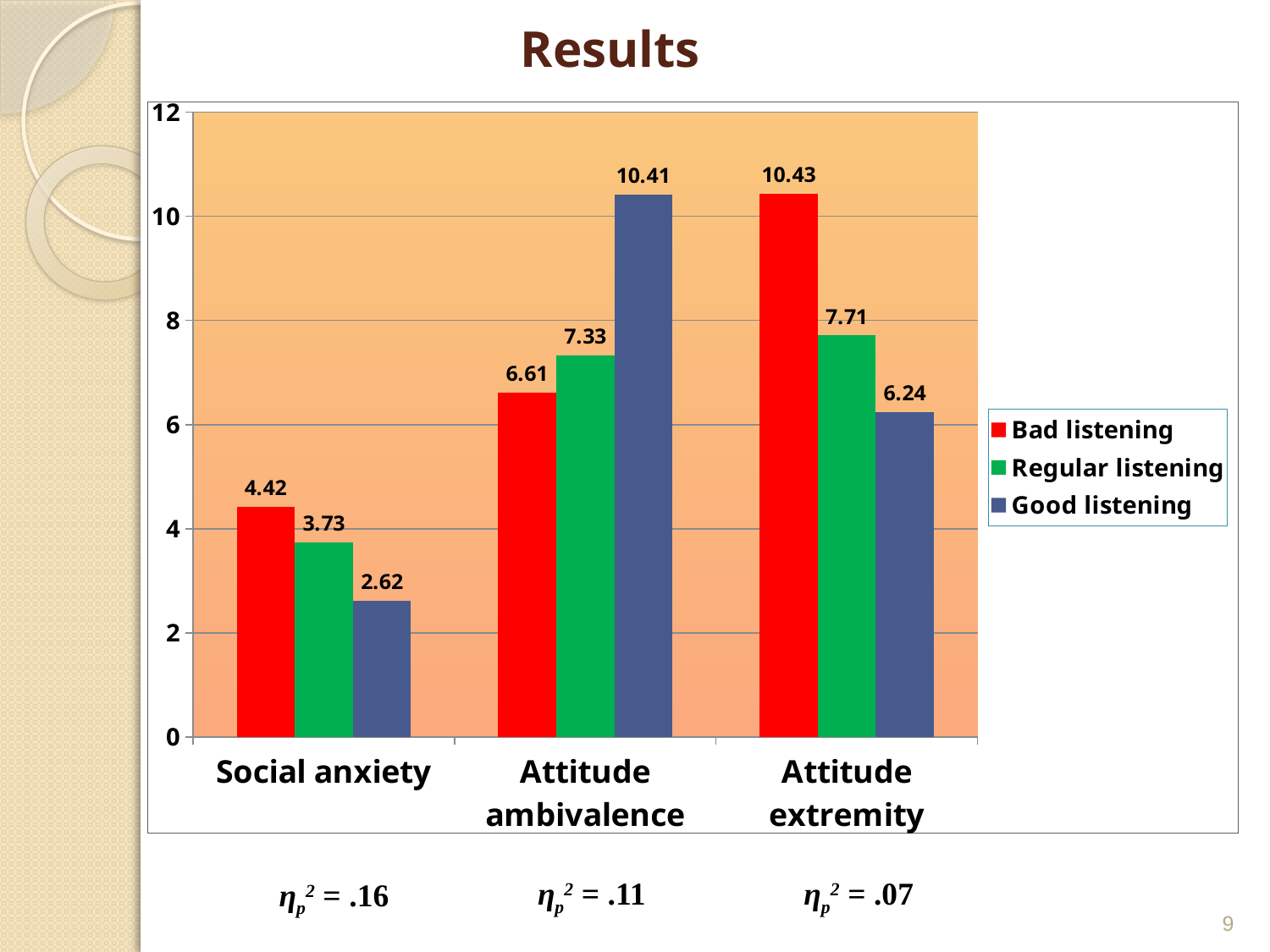
How many categories are shown on the x axis? 3 What is the value for Bad listening in the Social anxiety category? 4.42 What is the difference between the Bad listening and Good listening values in the Attitude extremity category? 4.19 What is the difference between the Good listening and Bad listening values in the Attitude ambivalence category? 3.80 How many series does the legend list? 3 What kind of chart is shown on the slide? Bar chart Which listening condition has the highest value in the Attitude extremity category? Bad listening Which is larger: the Regular listening value for Attitude ambivalence or the Regular listening value for Attitude extremity? Attitude extremity Which listening condition has the lowest value in the Social anxiety category? Good listening What is the value for Good listening in the Attitude ambivalence category? 10.41 What is the value for Regular listening in the Attitude extremity category? 7.71 Which colour represents Good listening in the legend? Blue